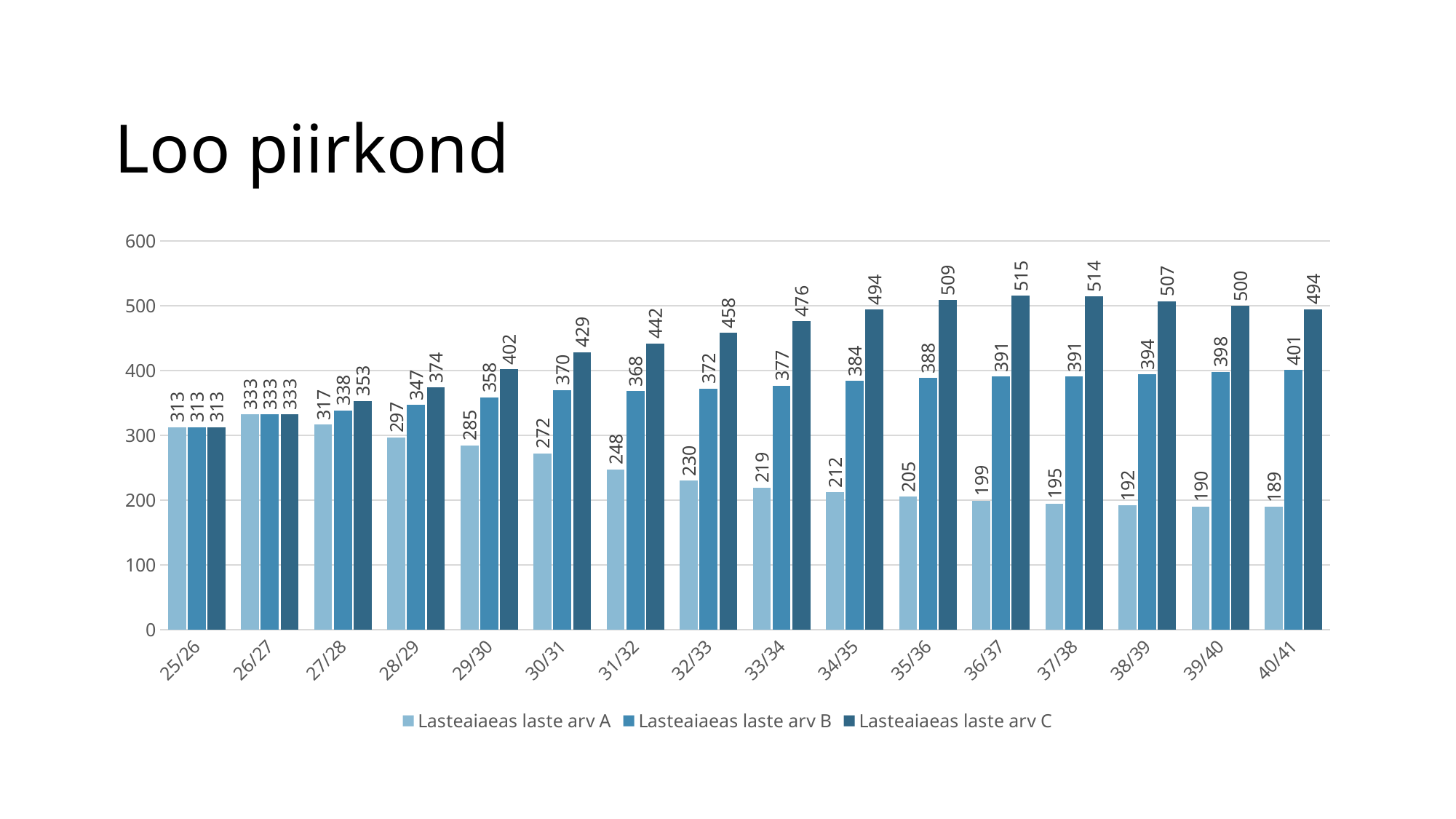
What is the value of Lasteaiaeas laste arv C for 36/37? 515 Which is larger for 29/30: Lasteaiaeas laste arv B or Lasteaiaeas laste arv C? Lasteaiaeas laste arv C What is the title of the slide? Loo piirkond What is the value of Lasteaiaeas laste arv A for 40/41? 189 How many series does the legend list? 3 Which category has the lowest value for Lasteaiaeas laste arv A? 40/41 What kind of chart is shown on the slide? Bar chart What is the value of Lasteaiaeas laste arv B for 32/33? 372 Does Lasteaiaeas laste arv A rise or fall from 27/28 to 40/41? Fall How many categories are shown on the x axis? 16 Which category has the highest value for Lasteaiaeas laste arv C? 36/37 What is the difference between Lasteaiaeas laste arv C and Lasteaiaeas laste arv A for 35/36? 304